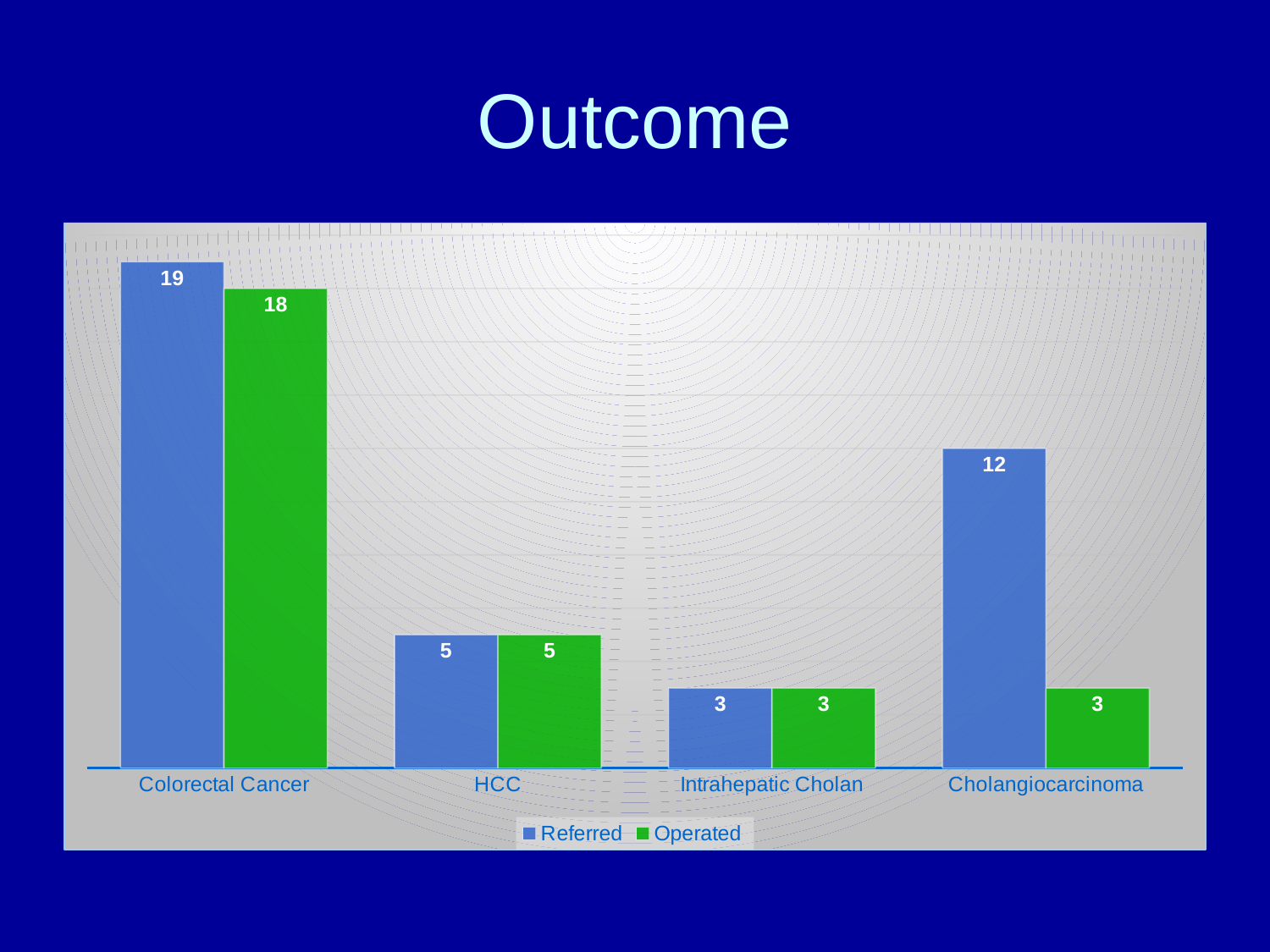
What is the Operated value for Cholangiocarcinoma? 3 What kind of chart is shown on the slide? Bar chart Which category has the highest Referred value? Colorectal Cancer How many series does the legend list? 2 Which category has the lowest Operated value? Intrahepatic Cholan and Cholangiocarcinoma (both 3) What is the difference between the Referred and Operated values for Cholangiocarcinoma? 9 How many categories are shown on the x axis? 4 Which is larger, the Referred value for Cholangiocarcinoma or the Referred value for HCC? Cholangiocarcinoma Which series is shown in green? Operated What is the Referred value for Colorectal Cancer? 19 What is the Operated value for HCC? 5 What is the difference between the Referred values for Colorectal Cancer and HCC? 14